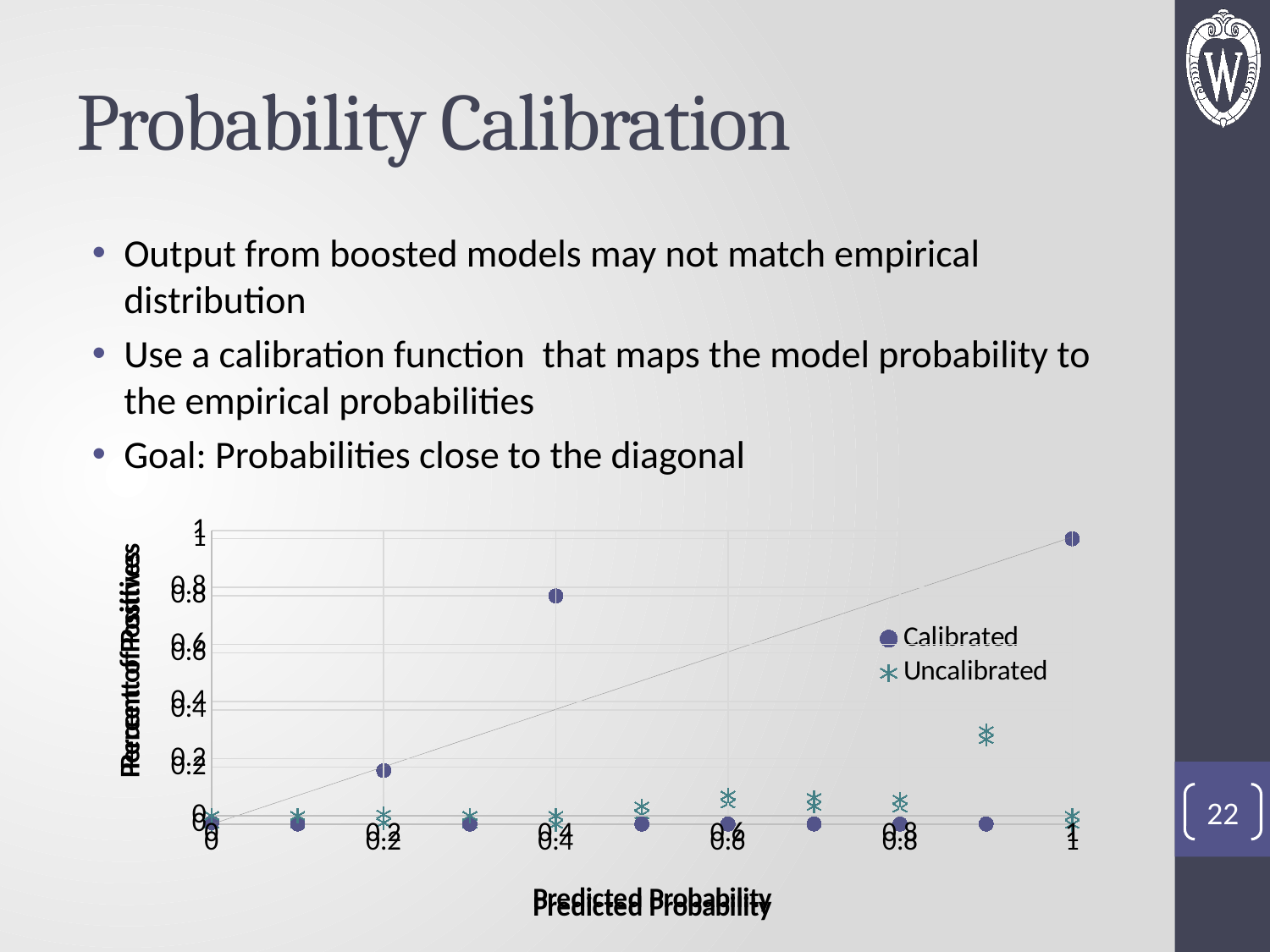
At which predicted probability does the Uncalibrated series reach its highest percent of positives? 0.9 How many series does the chart legend list? 2 Is the Calibrated value at a predicted probability of 1 greater or less than 0.8? greater What is the title of the chart's x axis? Predicted Probability At which predicted probability does the Calibrated series reach its highest percent of positives? 1 What kind of chart is shown on the slide? scatter chart At a predicted probability of 0.9, which series has the higher percent of positives, Calibrated or Uncalibrated? Uncalibrated Is the Uncalibrated value at a predicted probability of 0.9 greater or less than 0.4? less What are the two series named in the chart legend? Calibrated and Uncalibrated Is the Calibrated value at a predicted probability of 0.4 greater or less than 0.6? greater At a predicted probability of 0.4, which series has the higher percent of positives, Calibrated or Uncalibrated? Calibrated